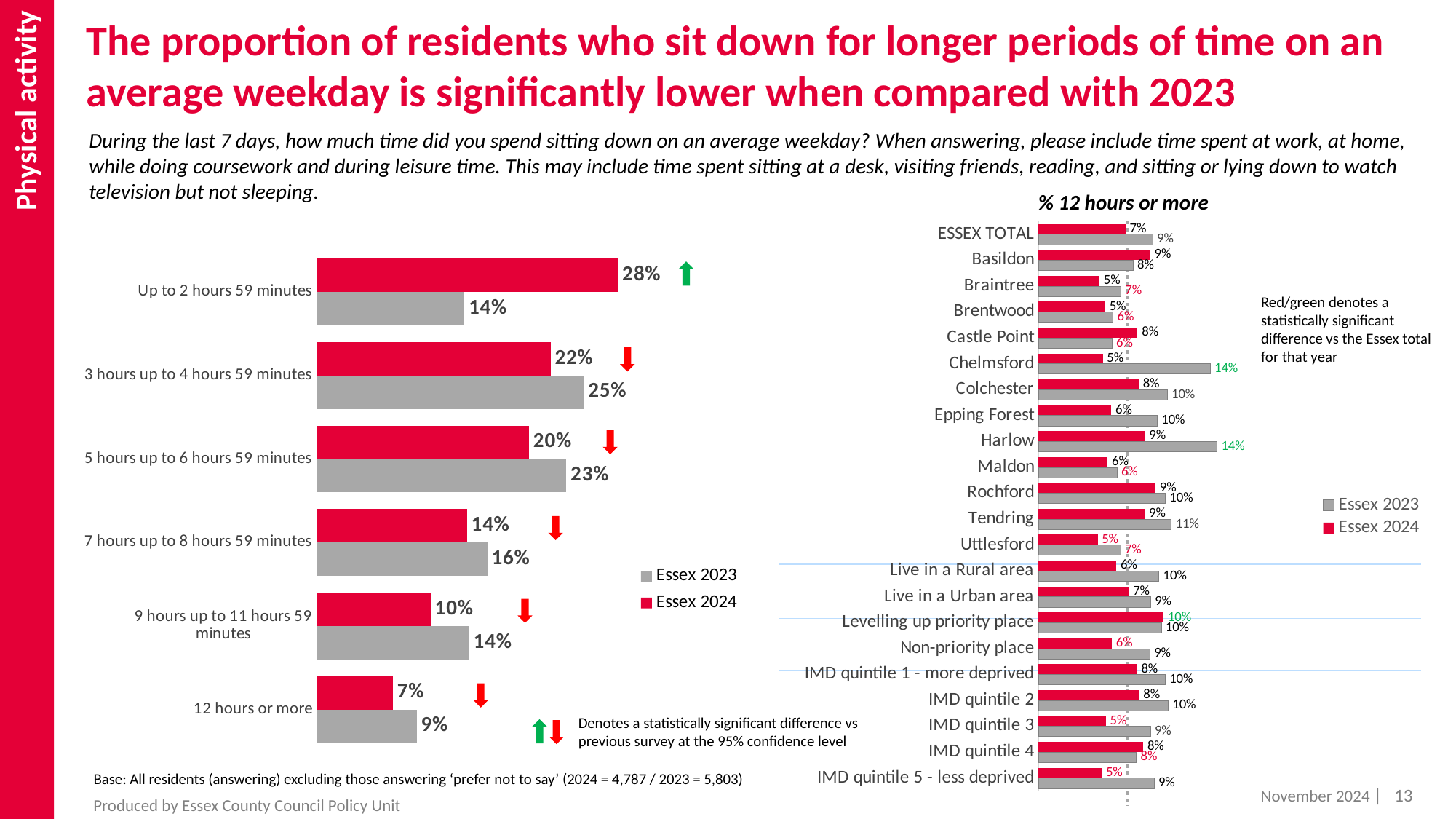
On the left chart, which category has the lowest Essex 2023 value? 12 hours or more On the left chart, what is the Essex 2024 value for 'Up to 2 hours 59 minutes'? 28% On the left chart, what is the Essex 2023 value for '9 hours up to 11 hours 59 minutes'? 14% On the left chart, what is the difference between the Essex 2024 and Essex 2023 values for 'Up to 2 hours 59 minutes'? 14% On the left chart, how many series does the legend list? 2 On the left chart, which category has the highest Essex 2024 value? Up to 2 hours 59 minutes What type of chart is the '% 12 hours or more' chart on the right? Bar chart On the '% 12 hours or more' chart, what is the difference between the Essex 2023 and Essex 2024 values for IMD quintile 5 - less deprived? 4% On the '% 12 hours or more' chart, what is the Essex 2023 value for Chelmsford? 14% On the left chart, how many sitting-time categories are shown? 6 On the '% 12 hours or more' chart, what is the Essex 2024 value for Basildon? 9% On the '% 12 hours or more' chart, which is larger for Harlow: the Essex 2023 value or the Essex 2024 value? Essex 2023